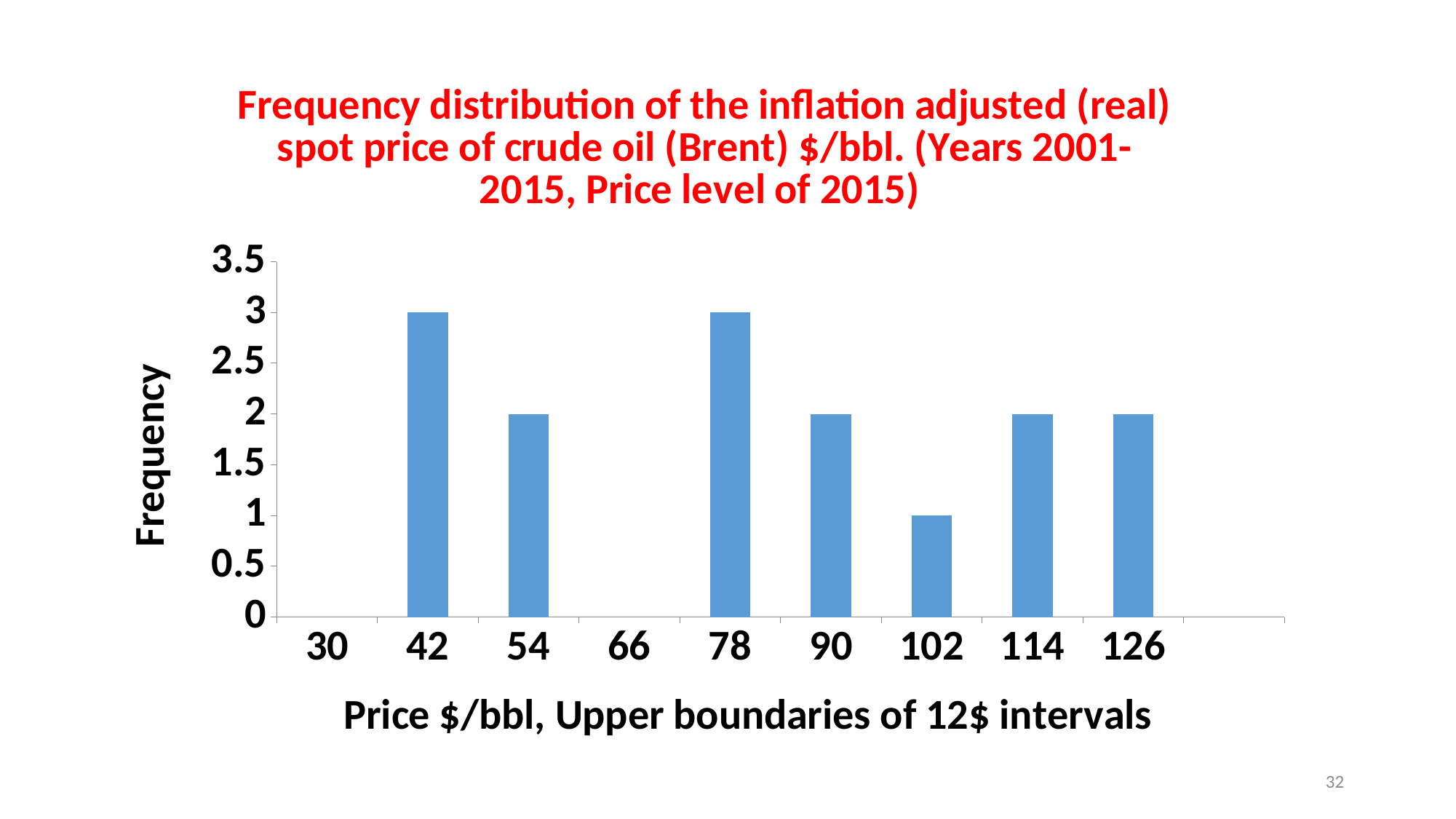
Which has a higher frequency, the 54 interval or the 102 interval? 54 What is the frequency for the 42 price interval? 3 What is the frequency for the 102 price interval? 1 Which price interval has the lowest non-zero frequency? 102 What is the frequency for the 78 price interval? 3 Which two price intervals have the highest frequency? 42 and 78 How many price intervals are labelled on the x axis? 9 What is the difference between the frequency for 78 and the frequency for 102? 2 What type of chart is shown on the slide? Bar chart What is the frequency for the 66 price interval? 0 What is the frequency for the 114 price interval? 2 What is the label of the y axis? Frequency